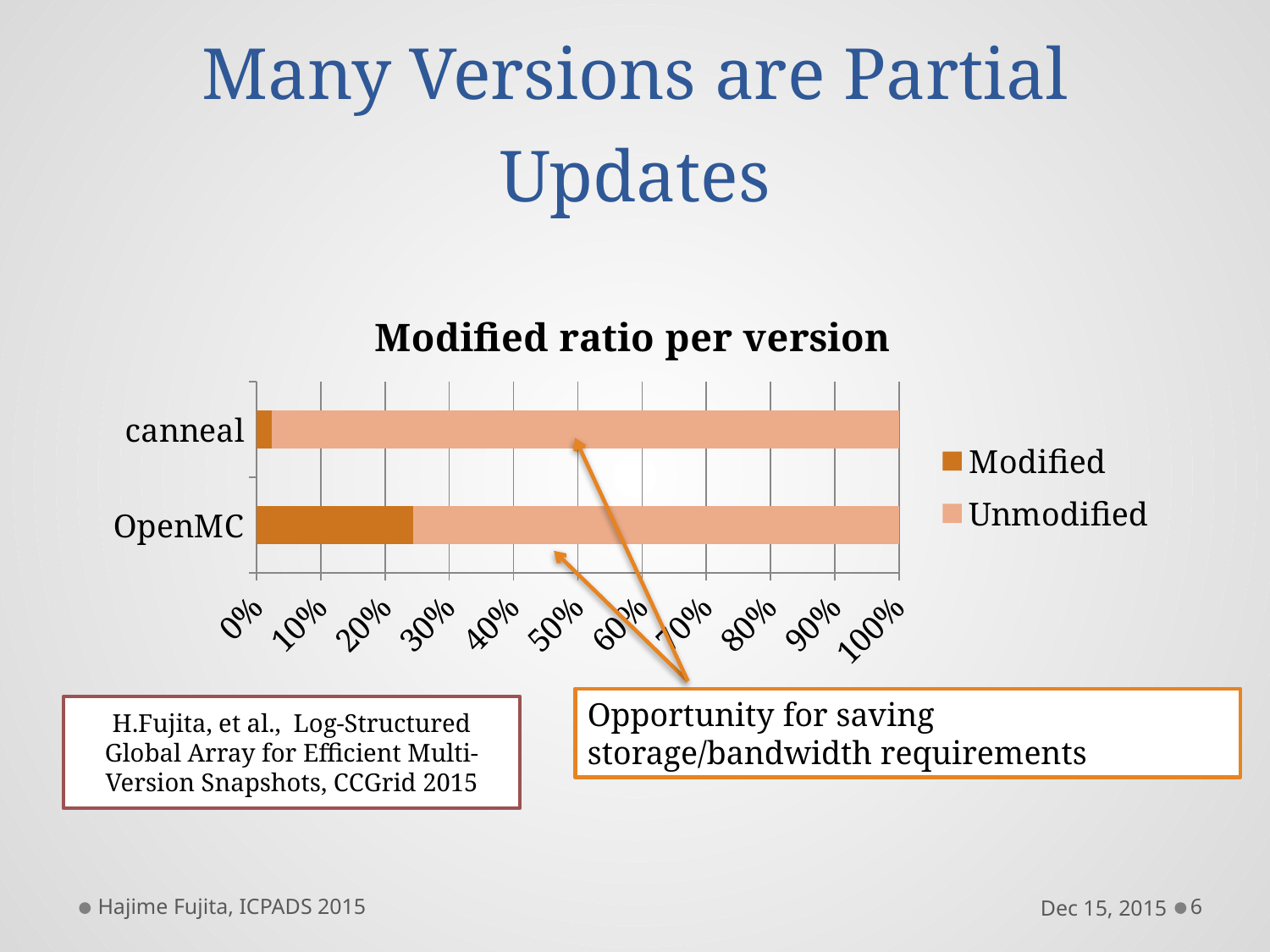
Is the Modified value for OpenMC greater or less than 20%? greater Which series are listed in the chart's legend? Modified and Unmodified What is the total of the stacked bar for canneal? 100% Is the Modified value for OpenMC greater or less than 30%? less Which category has the smallest Modified share? canneal What is the title of the chart? Modified ratio per version How many series does the chart's legend list? 2 Which category has the largest Unmodified share? canneal Is the Modified value for canneal greater or less than 10%? less How many categories are plotted on the chart? 2 What kind of chart is shown on the slide? Stacked bar chart Which category has the larger Modified share, canneal or OpenMC? OpenMC